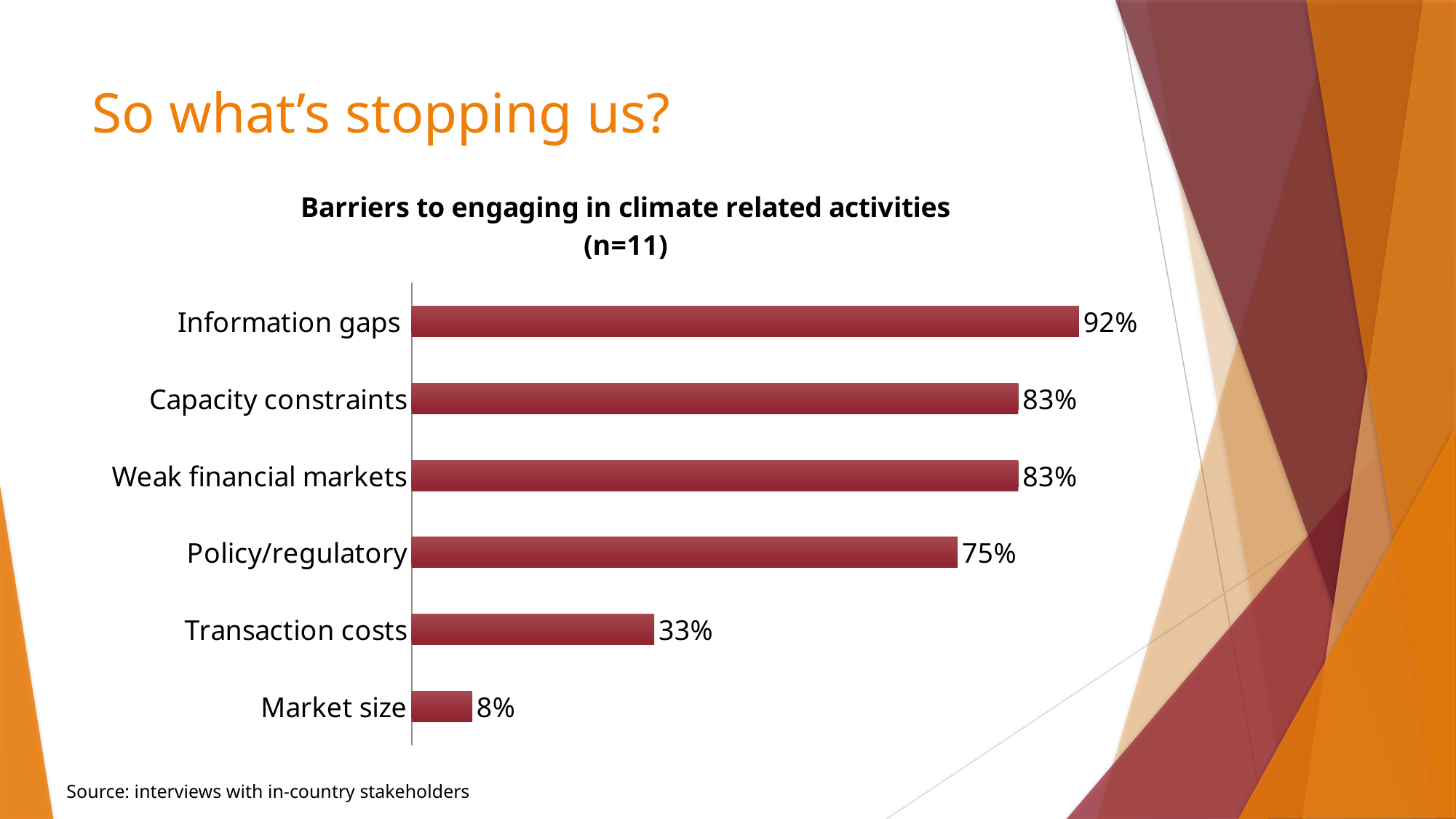
What is the difference between the values for Transaction costs and Market size? 25% What is the value for Policy/regulatory? 75% What is the value for Transaction costs? 33% What is the value for Information gaps? 92% What is the title of the chart? Barriers to engaging in climate related activities (n=11) Which barrier has the lowest value? Market size What is the difference between the values for Information gaps and Policy/regulatory? 17% How many barriers are shown in the chart? 6 What is the value for Market size? 8% Which is larger, the value for Policy/regulatory or the value for Transaction costs? Policy/regulatory What kind of chart is shown on the slide? Bar chart Which barrier has the highest value? Information gaps